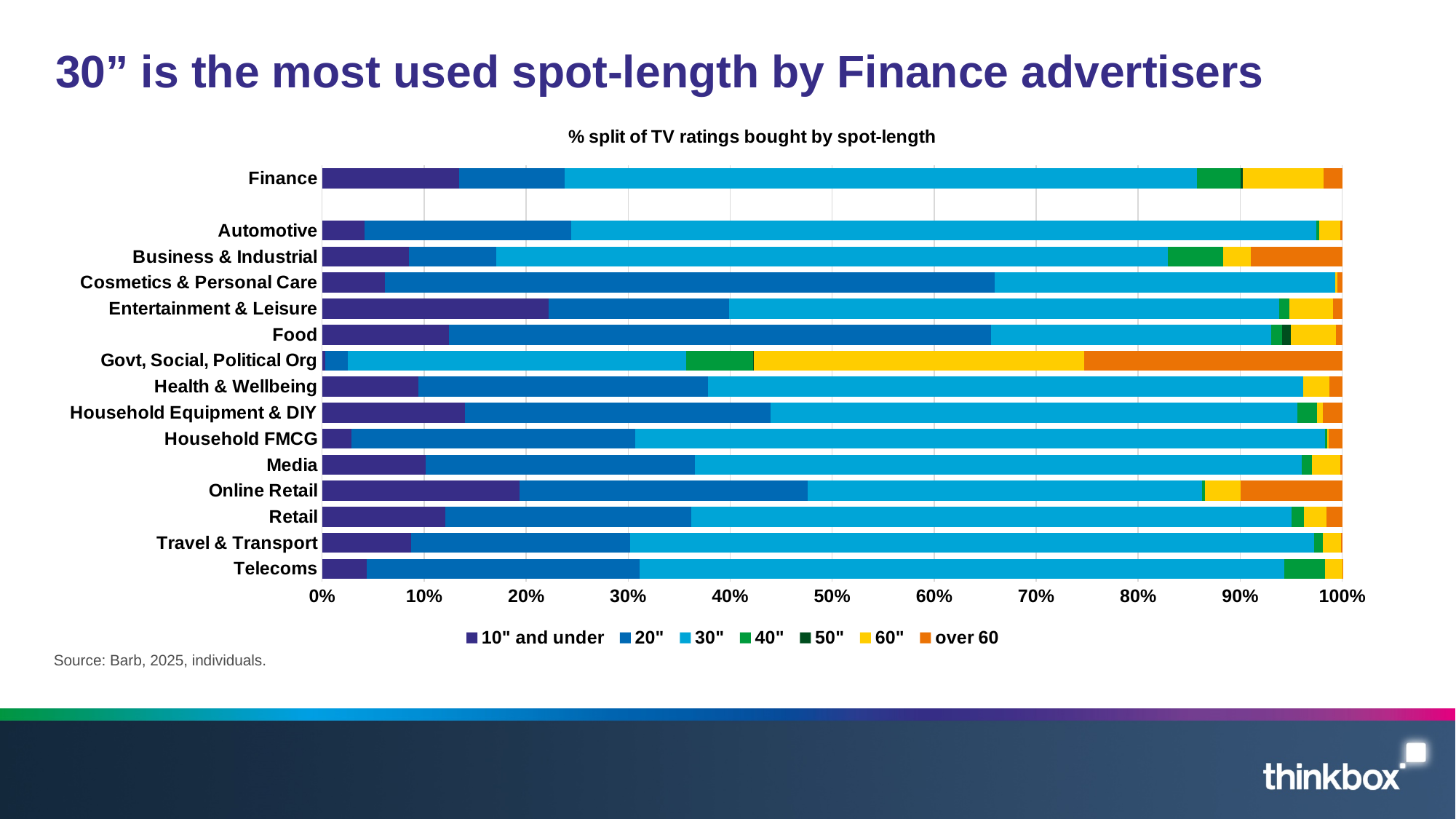
Which category has the largest 20" share? Cosmetics & Personal Care What kind of chart is shown on the slide? Stacked bar chart What is the title of the chart? % split of TV ratings bought by spot-length Which has the larger 60" share, Govt, Social, Political Org or Finance? Govt, Social, Political Org Is the 20" share for Cosmetics & Personal Care greater or less than 50%? greater How many advertiser categories are plotted in the chart? 15 Which category has the largest 30" share? Automotive What source is cited for the chart data? Barb, 2025, individuals. How many spot-length series does the legend list? 7 Is the 30" share for Finance greater or less than 50%? greater Which category has the largest 'over 60' share? Govt, Social, Political Org Is the 10" and under share for Automotive greater or less than 10%? less